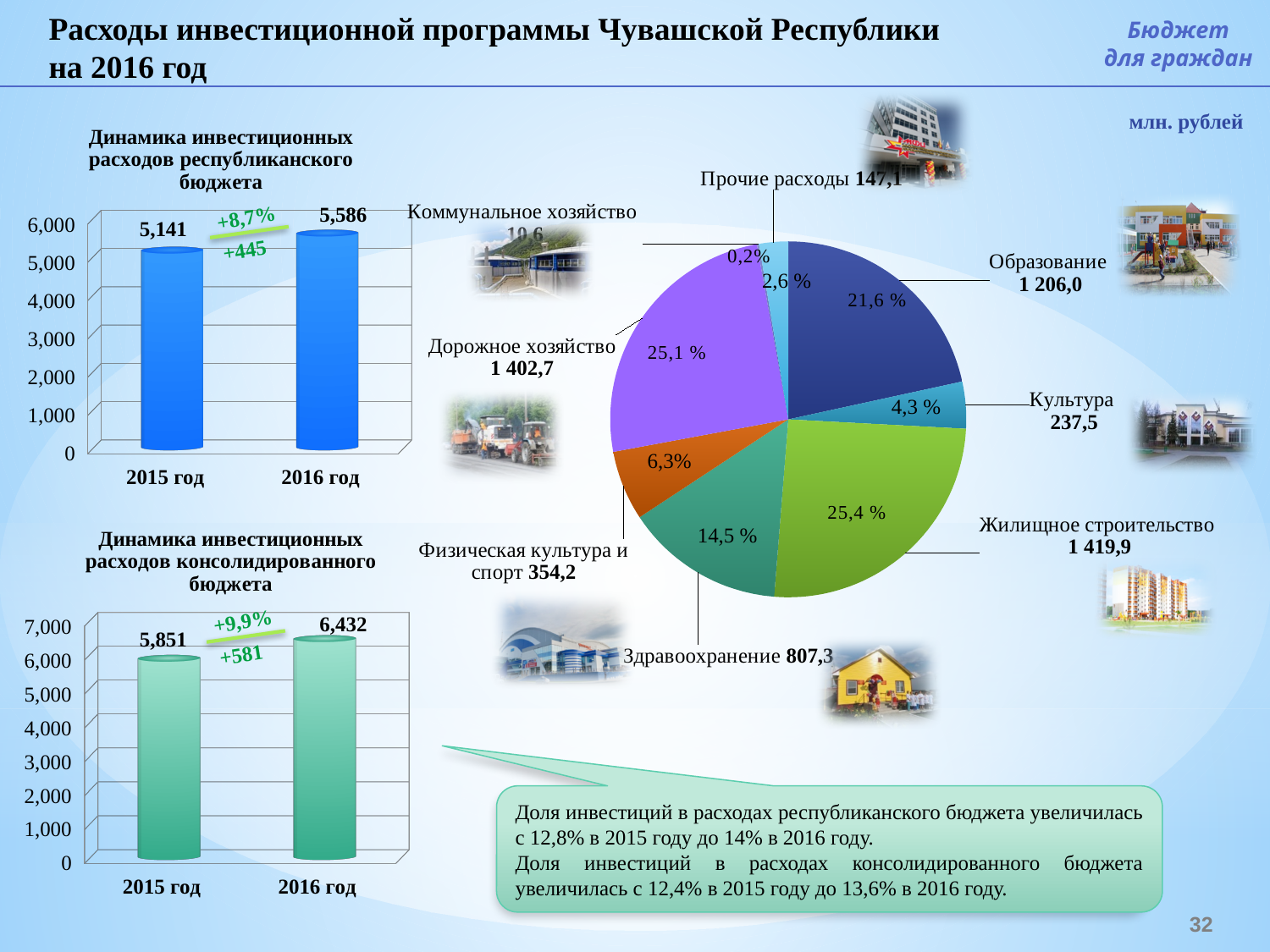
In the pie chart, what share does Образование have? 21,6 % In the chart 'Динамика инвестиционных расходов республиканского бюджета', what is the difference between the 2016 год and 2015 год values? 445 In the chart 'Динамика инвестиционных расходов республиканского бюджета', what is the value for 2016 год? 5,586 In the pie chart, which is larger: Здравоохранение or Культура? Здравоохранение In the chart 'Динамика инвестиционных расходов консолидированного бюджета', do the values rise or fall from 2015 год to 2016 год? rise In the chart 'Динамика инвестиционных расходов консолидированного бюджета', what percentage growth is shown between 2015 год and 2016 год? +9,9% In the chart 'Динамика инвестиционных расходов консолидированного бюджета', what is the value for 2016 год? 6,432 In the chart 'Динамика инвестиционных расходов консолидированного бюджета', which year has the higher value? 2016 год In the pie chart, which category has the largest share? Жилищное строительство What kind of chart is 'Динамика инвестиционных расходов республиканского бюджета'? bar chart In the chart 'Динамика инвестиционных расходов республиканского бюджета', what is the value for 2015 год? 5,141 In the pie chart, what is the value for Жилищное строительство? 1 419,9